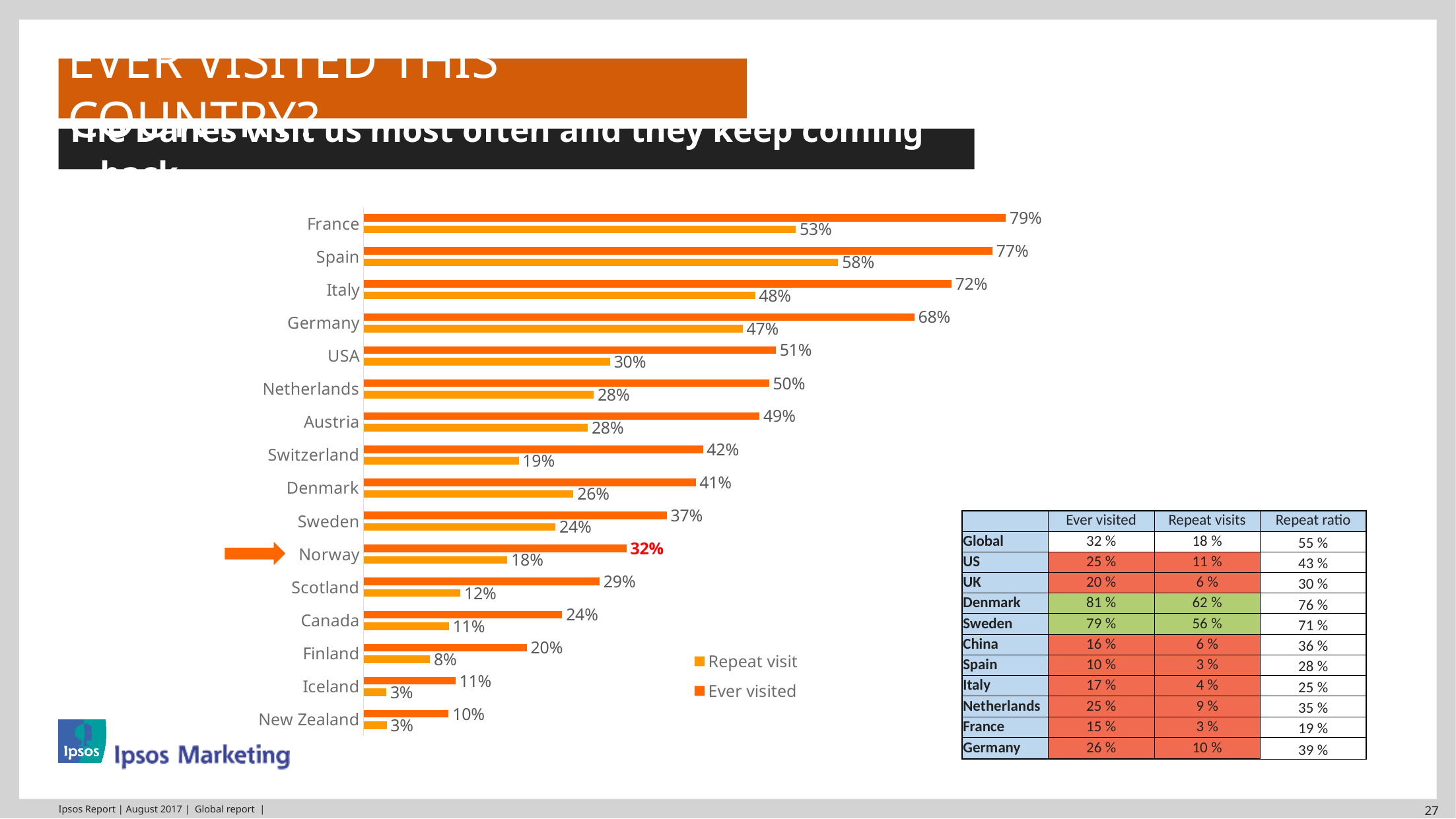
How many countries are shown in the bar chart? 16 Which country has the highest 'Ever visited' value? France What is the difference between the 'Ever visited' and 'Repeat visit' values for Germany? 21% What kind of chart is shown on the slide? Bar chart What is the 'Repeat visit' value for Spain? 58% How many series does the chart legend list? 2 Which country has the lowest 'Ever visited' value? New Zealand What is the 'Ever visited' value for France? 79% Which is larger, the 'Ever visited' value for Italy or for Germany? Italy What is the 'Ever visited' value for Norway? 32% What is the 'Repeat visit' value for Denmark? 26% Which country has the highest 'Repeat visit' value? Spain